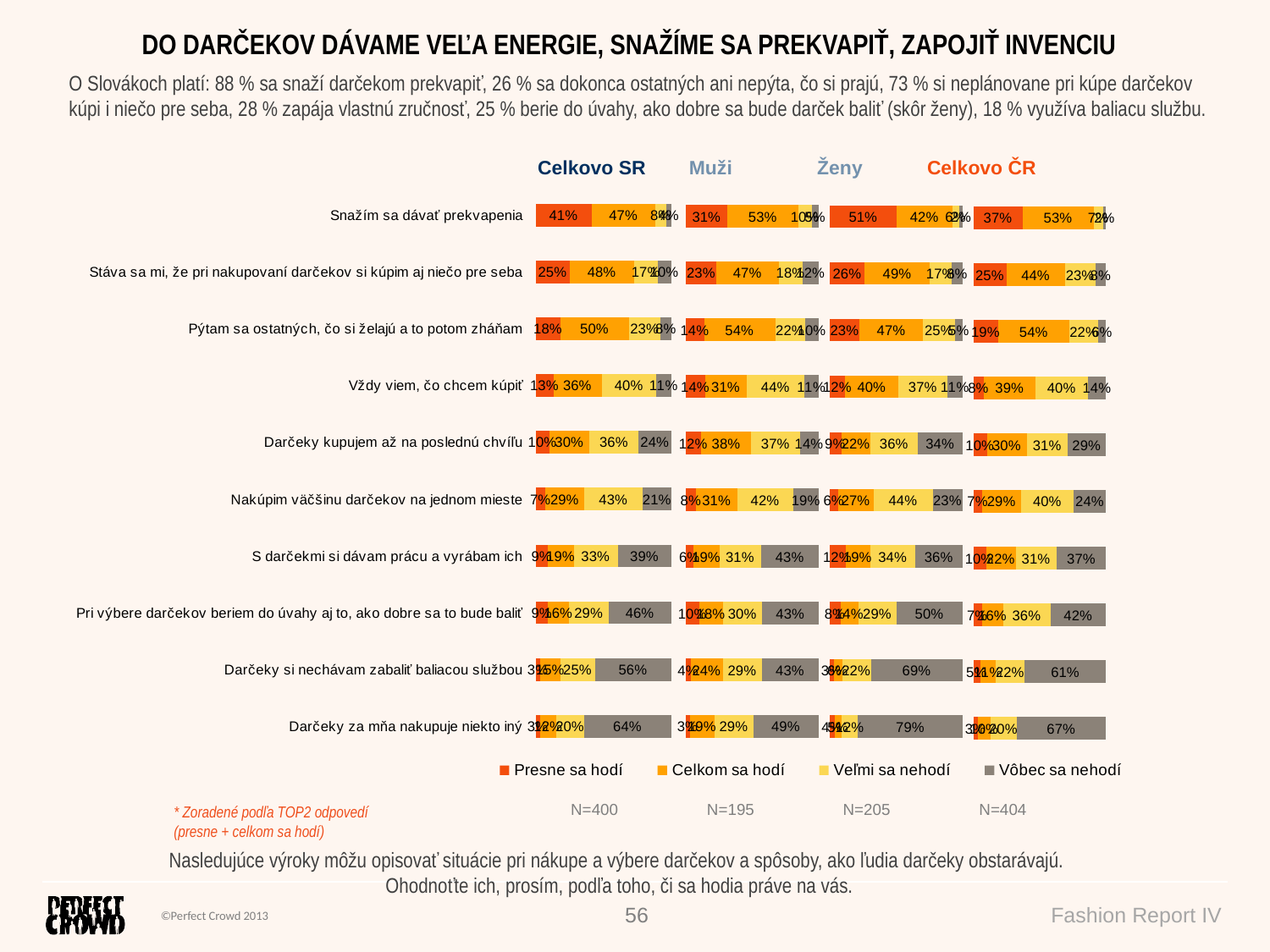
What is the sample size (N) shown for the Celkovo ČR chart? N=404 In the Celkovo SR chart, which statement has the highest "Vôbec sa nehodí" share? Darčeky za mňa nakupuje niekto iný What is the difference between the "Presne sa hodí" share for "Snažím sa dávať prekvapenia" in the Ženy chart and in the Muži chart? 20 percentage points How many series does the legend list? 4 In the Muži chart, what percentage answered "Celkom sa hodí" for "Pýtam sa ostatných, čo si želajú a to potom zháňam"? 54% In the Celkovo ČR chart, what percentage answered "Vôbec sa nehodí" for "Darčeky si nechávam zabaliť baliacou službou"? 61% In the Ženy chart, what percentage answered "Vôbec sa nehodí" for "Darčeky za mňa nakupuje niekto iný"? 79% In the Celkovo SR chart, what percentage answered "Presne sa hodí" for "Snažím sa dávať prekvapenia"? 41% In the Ženy chart, which statement has the highest "Presne sa hodí" share? Snažím sa dávať prekvapenia Is the "Vôbec sa nehodí" share for "Darčeky si nechávam zabaliť baliacou službou" larger in the Ženy chart or in the Muži chart? Ženy How many statements (categories) are plotted in each chart? 10 What type of chart is used on this slide? Stacked bar chart